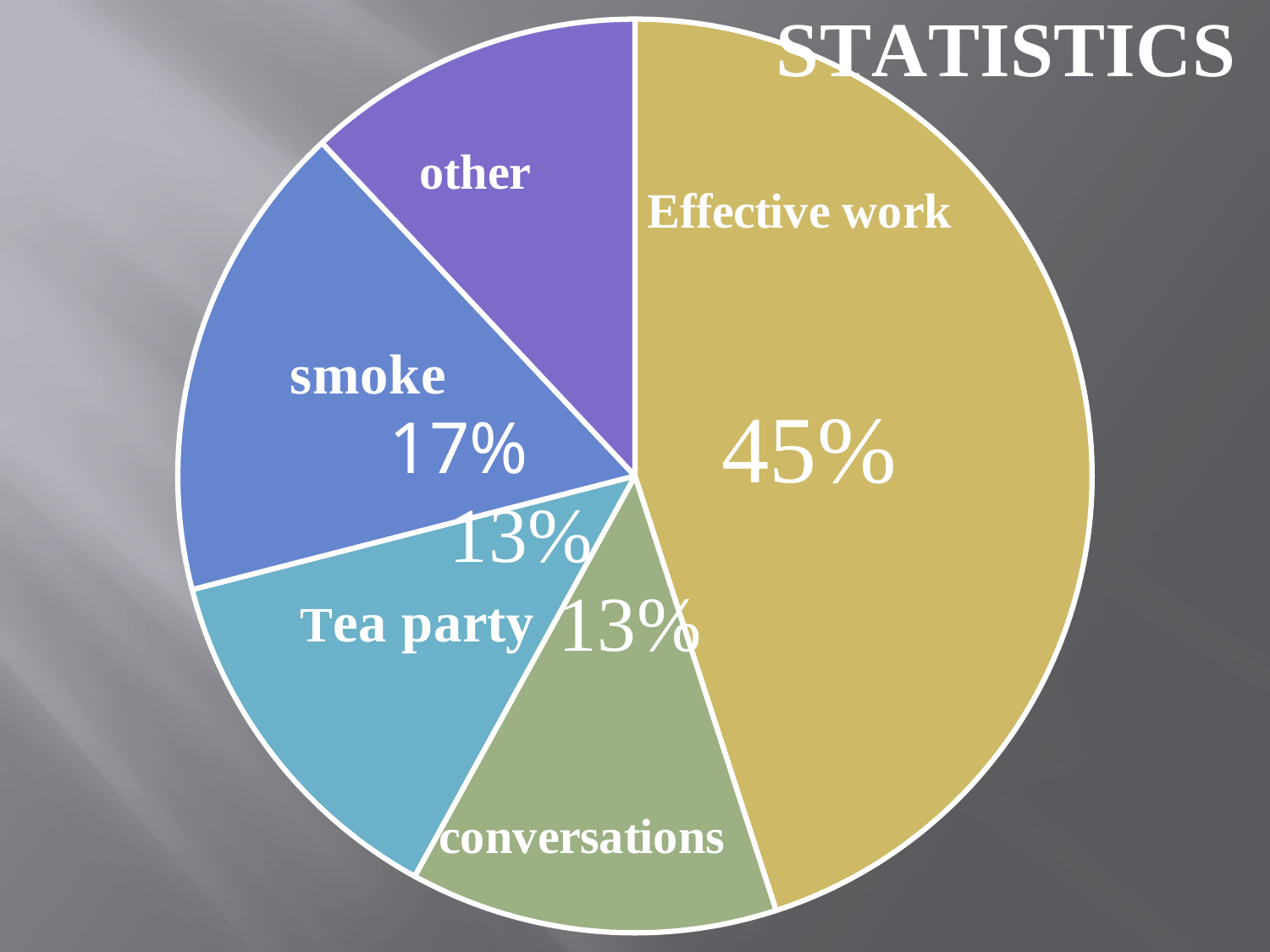
How many percentage points larger is Effective work than smoke? 28% What is the title of the chart? STATISTICS What percentage is shown for Tea party? 13% Which slice is larger, other or Effective work? Effective work What is the difference between the smoke and Tea party percentages? 4% How many slices does the pie chart have? 5 What percentage is shown for the smoke slice? 17% Which slice of the pie is the largest? Effective work What percentage of the pie is Effective work? 45% What kind of chart is shown on the slide? Pie chart What percentage is shown for conversations? 13% Which is larger, Effective work or smoke? Effective work